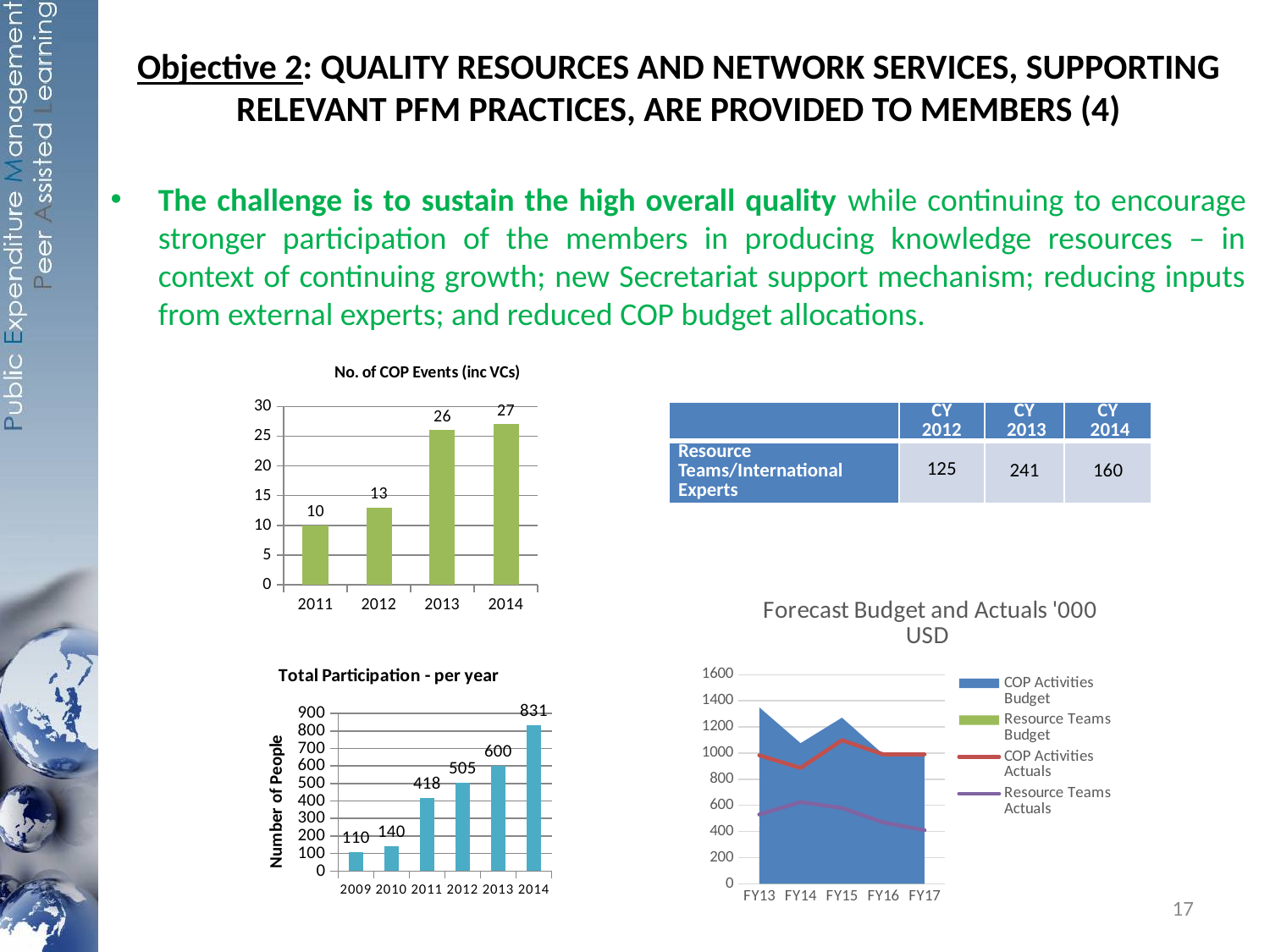
In the 'Total Participation - per year' chart, what is the label on the y axis? Number of People In the 'Forecast Budget and Actuals '000 USD' chart, is the Resource Teams Actuals value for FY17 greater or less than 600? less In the 'No. of COP Events (inc VCs)' chart, how many years are shown on the x axis? 4 In the 'No. of COP Events (inc VCs)' chart, which year has the lowest number of events? 2011 In the 'Total Participation - per year' chart, what is the difference between the 2014 and 2013 values? 231 How many series does the legend of the 'Forecast Budget and Actuals '000 USD' chart list? 4 In the 'Total Participation - per year' chart, do the values rise or fall from 2009 to 2014? rise In the 'No. of COP Events (inc VCs)' chart, what is the difference between the 2014 and 2012 values? 14 In the 'Forecast Budget and Actuals '000 USD' chart, is the COP Activities Actuals value for FY15 greater or less than 1000? greater In the 'Total Participation - per year' chart, which year has the highest participation? 2014 In the 'No. of COP Events (inc VCs)' chart, how many COP events were there in 2013? 26 In the 'Total Participation - per year' chart, what is the value for 2012? 505